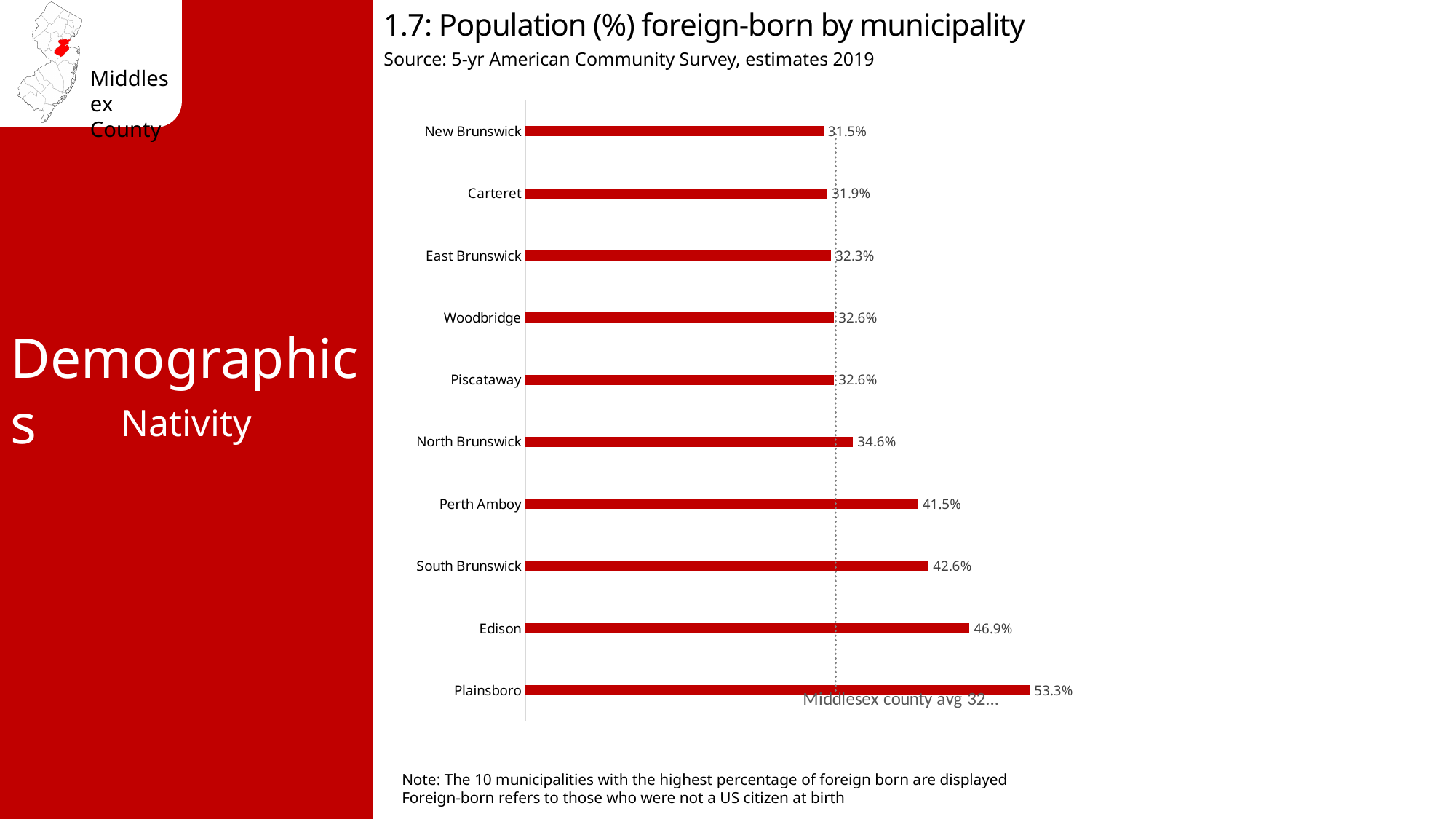
What is the percentage of foreign-born population in Perth Amboy? 41.5% What is the difference in percentage points between Plainsboro and Edison? 6.4 Which municipality has the lowest percentage of foreign-born population shown on the chart? New Brunswick What is the title of the chart? 1.7: Population (%) foreign-born by municipality What is the percentage of foreign-born population in Edison? 46.9% Which has a higher foreign-born percentage, Perth Amboy or South Brunswick? South Brunswick How many municipalities are shown on the chart? 10 What type of chart is used to show the foreign-born population by municipality? Bar chart What is the percentage of foreign-born population in Plainsboro? 53.3% What is the percentage of foreign-born population in New Brunswick? 31.5% Which municipality has the highest percentage of foreign-born population? Plainsboro What is the difference in percentage points between South Brunswick and North Brunswick? 8.0